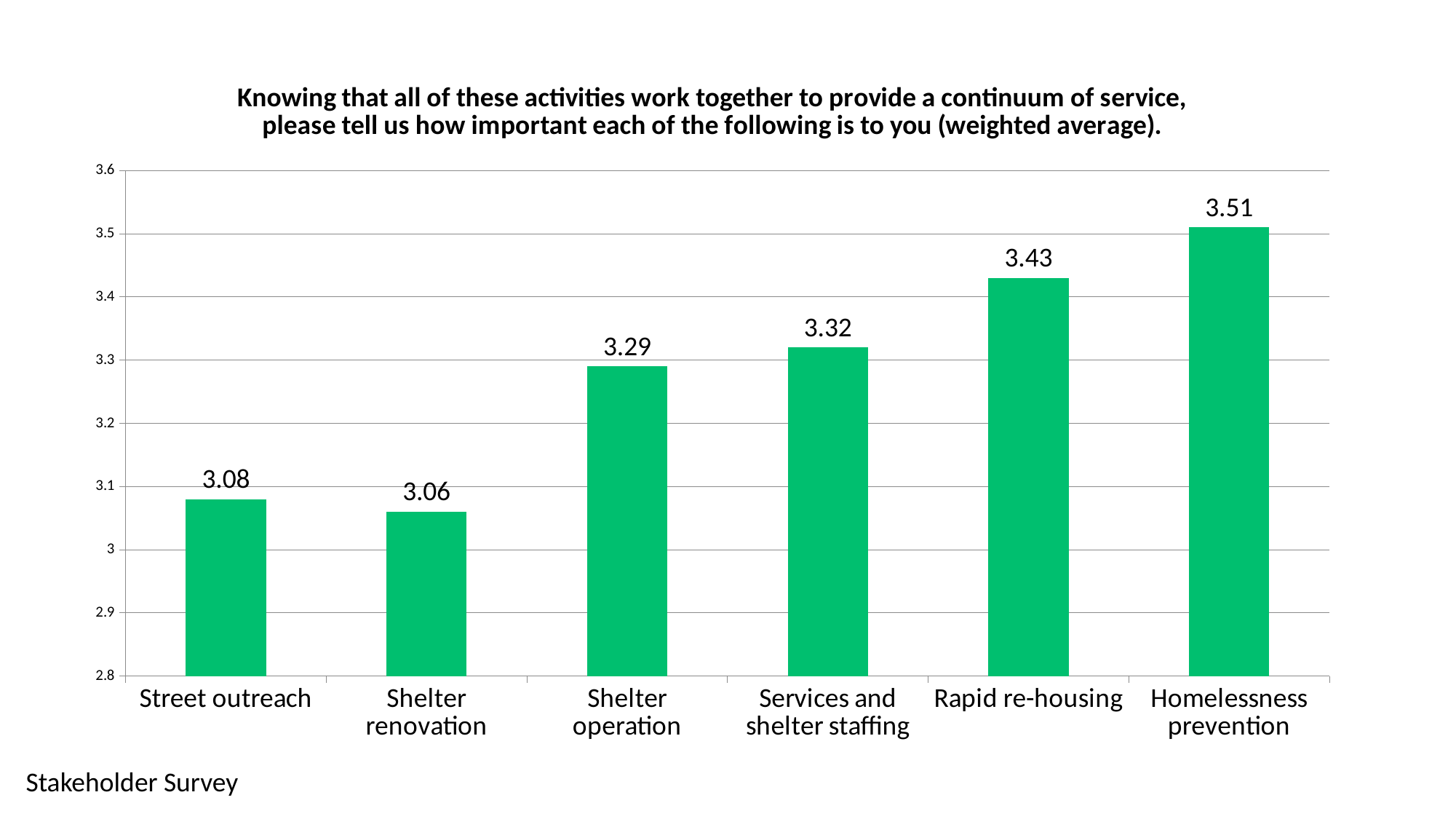
How many activities are shown on the chart? 6 What kind of chart is shown on the slide? Bar chart What is the value shown for Services and shelter staffing? 3.32 Which activity has the lowest weighted average? Shelter renovation Which activity has the highest weighted average? Homelessness prevention Which has a higher value, Shelter operation or Rapid re-housing? Rapid re-housing What is the weighted average value for Homelessness prevention? 3.51 What source is cited at the bottom left of the slide? Stakeholder Survey Is the value for Rapid re-housing greater or less than 3.4? greater What is the weighted average value for Shelter renovation? 3.06 What is the difference between the values for Homelessness prevention and Street outreach? 0.43 What is the difference between the values for Rapid re-housing and Shelter operation? 0.14